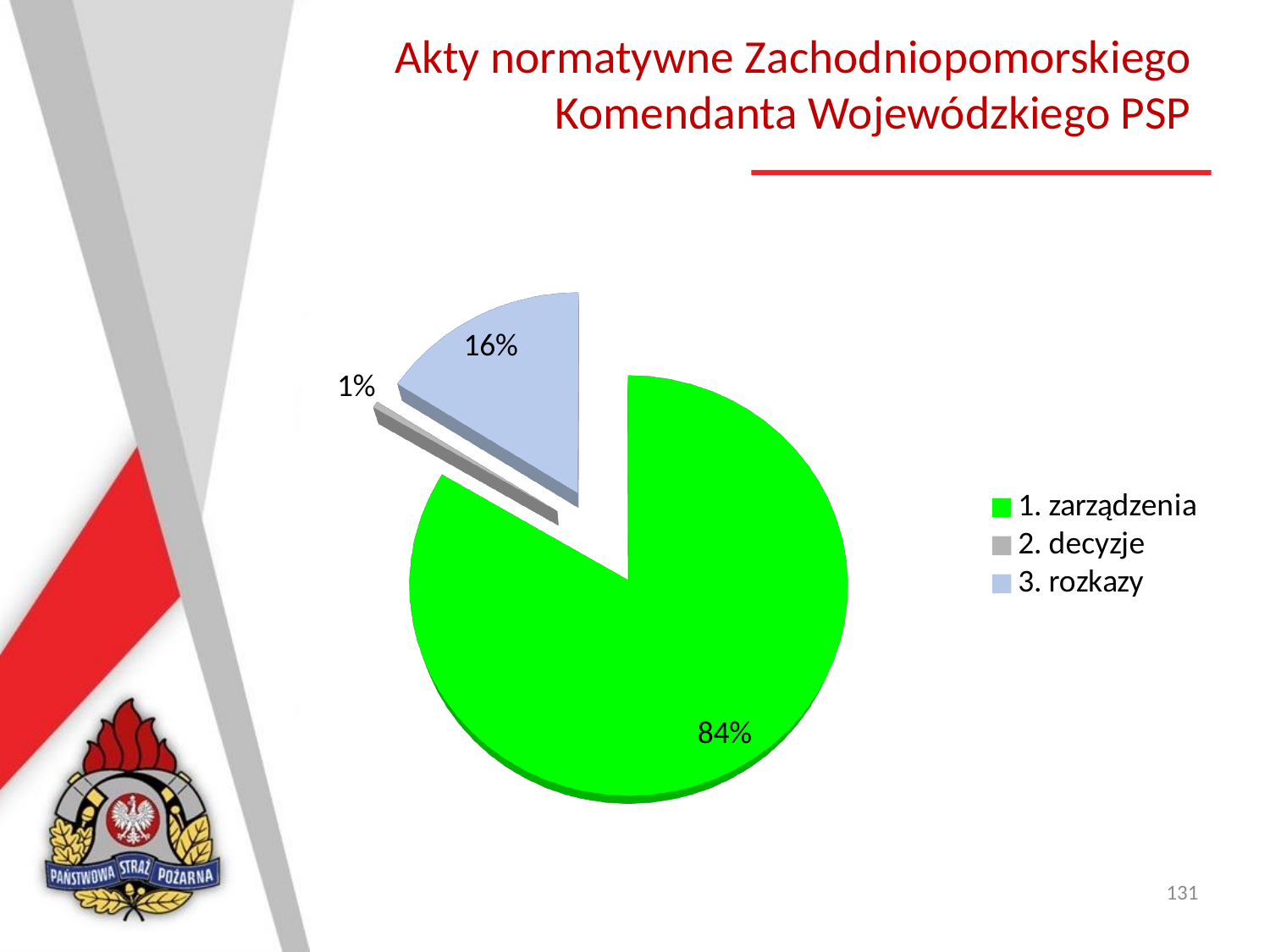
Which category has the smallest slice of the pie? 2. decyzje How many entries does the legend list? 3 Which legend entry is shown in light blue? 3. rozkazy Which category has the largest slice of the pie? 1. zarządzenia What share of the pie does "1. zarządzenia" represent? 84% Which is larger, the share for "3. rozkazy" or the share for "2. decyzje"? 3. rozkazy What kind of chart is shown on the slide? pie chart What share of the pie does "2. decyzje" represent? 1% What share of the pie does "3. rozkazy" represent? 16% What is the difference in percentage points between "1. zarządzenia" and "3. rozkazy"? 68 What colour is the slice for "1. zarządzenia"? green How many categories does the pie chart have? 3